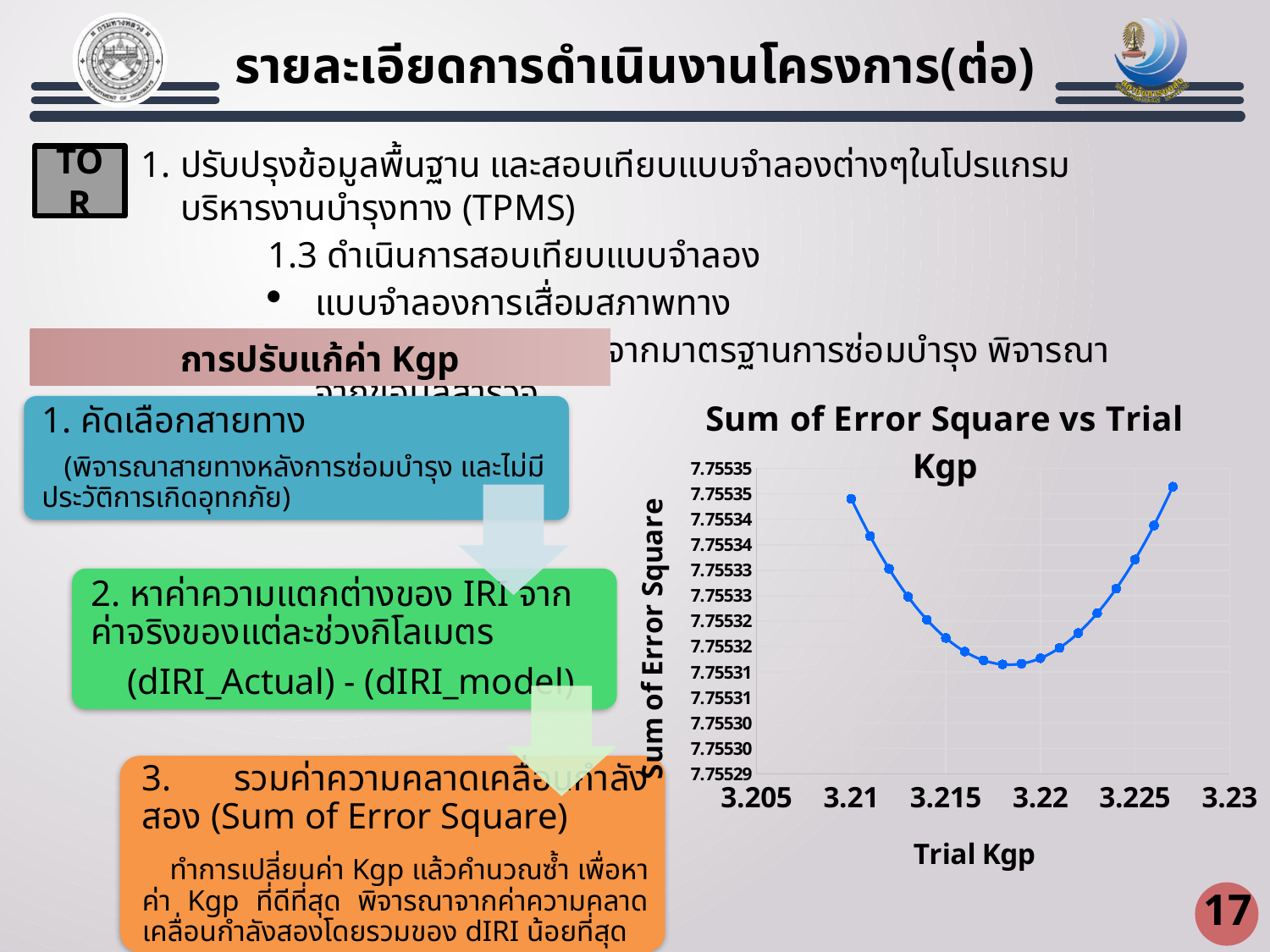
What is the label of the x axis of the chart? Trial Kgp How many data points are plotted on the chart? 18 How does the Sum of Error Square change as Trial Kgp increases from 3.21 to 3.23? It falls, then rises (U-shaped) Is the Sum of Error Square at Trial Kgp 3.21 greater or less than at Trial Kgp 3.225? greater How many tick labels are shown on the x axis of the chart? 6 What is the title of the chart? Sum of Error Square vs Trial Kgp Which has the larger Sum of Error Square: Trial Kgp 3.215 or Trial Kgp 3.225? 3.225 Is the lowest Sum of Error Square found between Trial Kgp 3.215 and 3.22, or between 3.225 and 3.23? Between 3.215 and 3.22 Which has the larger Sum of Error Square: Trial Kgp 3.21 or Trial Kgp 3.22? 3.21 Is the highest plotted Sum of Error Square at the left end or the right end of the curve? Right end Is the Sum of Error Square at Trial Kgp 3.22 greater or less than 7.75533? less What kind of chart is shown on the slide? Line chart